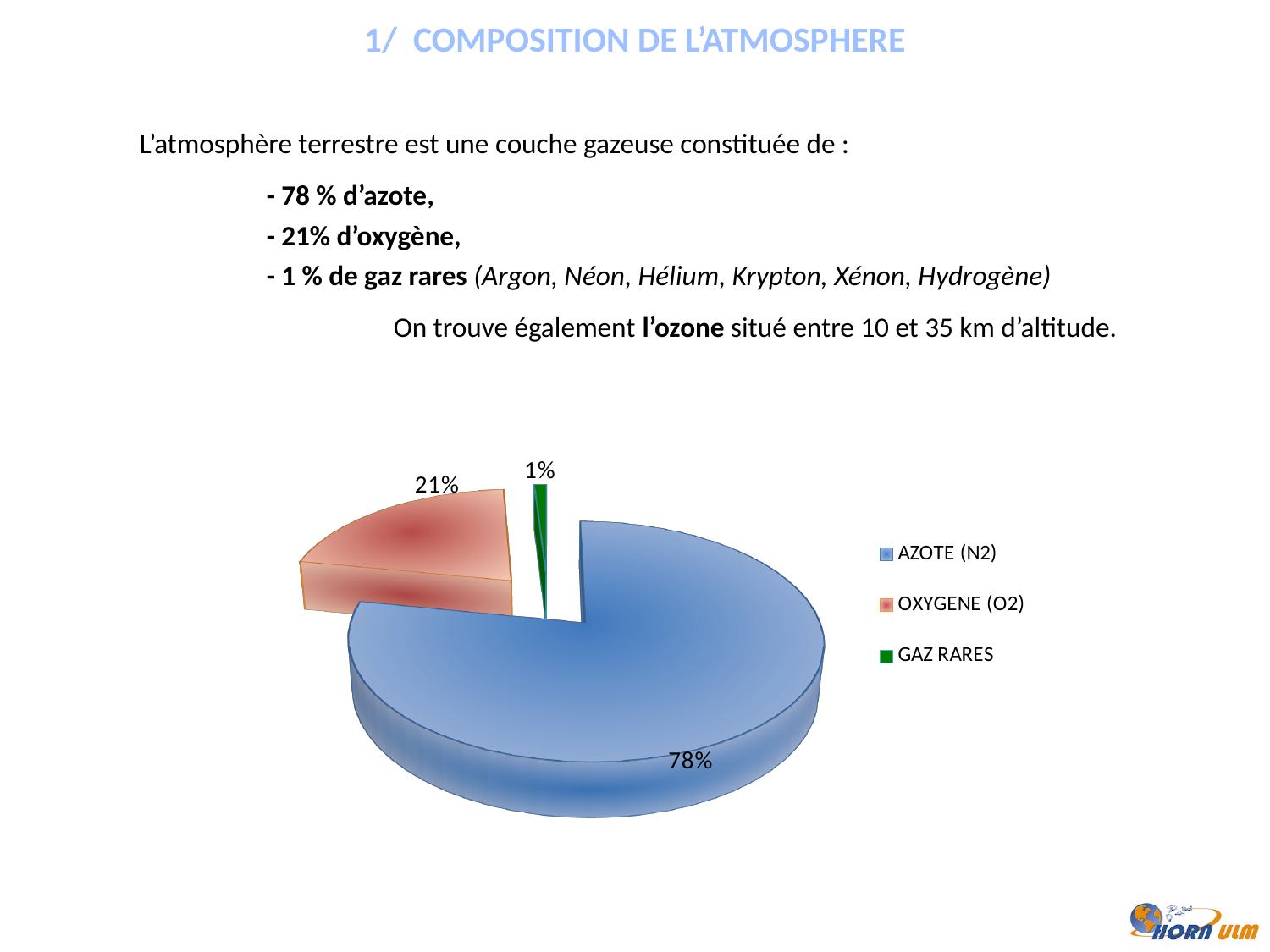
Which slice of the pie is the smallest? GAZ RARES Which is larger, the OXYGENE (O2) slice or the GAZ RARES slice? OXYGENE (O2) What share of the pie does GAZ RARES represent? 1% What is the difference between the AZOTE (N2) share and the OXYGENE (O2) share? 57% What kind of chart is shown on the slide? pie chart What share of the pie does AZOTE (N2) represent? 78% How many entries does the legend list? 3 What colour is the AZOTE (N2) slice? blue What share of the pie does OXYGENE (O2) represent? 21% Which slice of the pie is the largest? AZOTE (N2) How many slices does the pie chart have? 3 What colour is the GAZ RARES slice? green